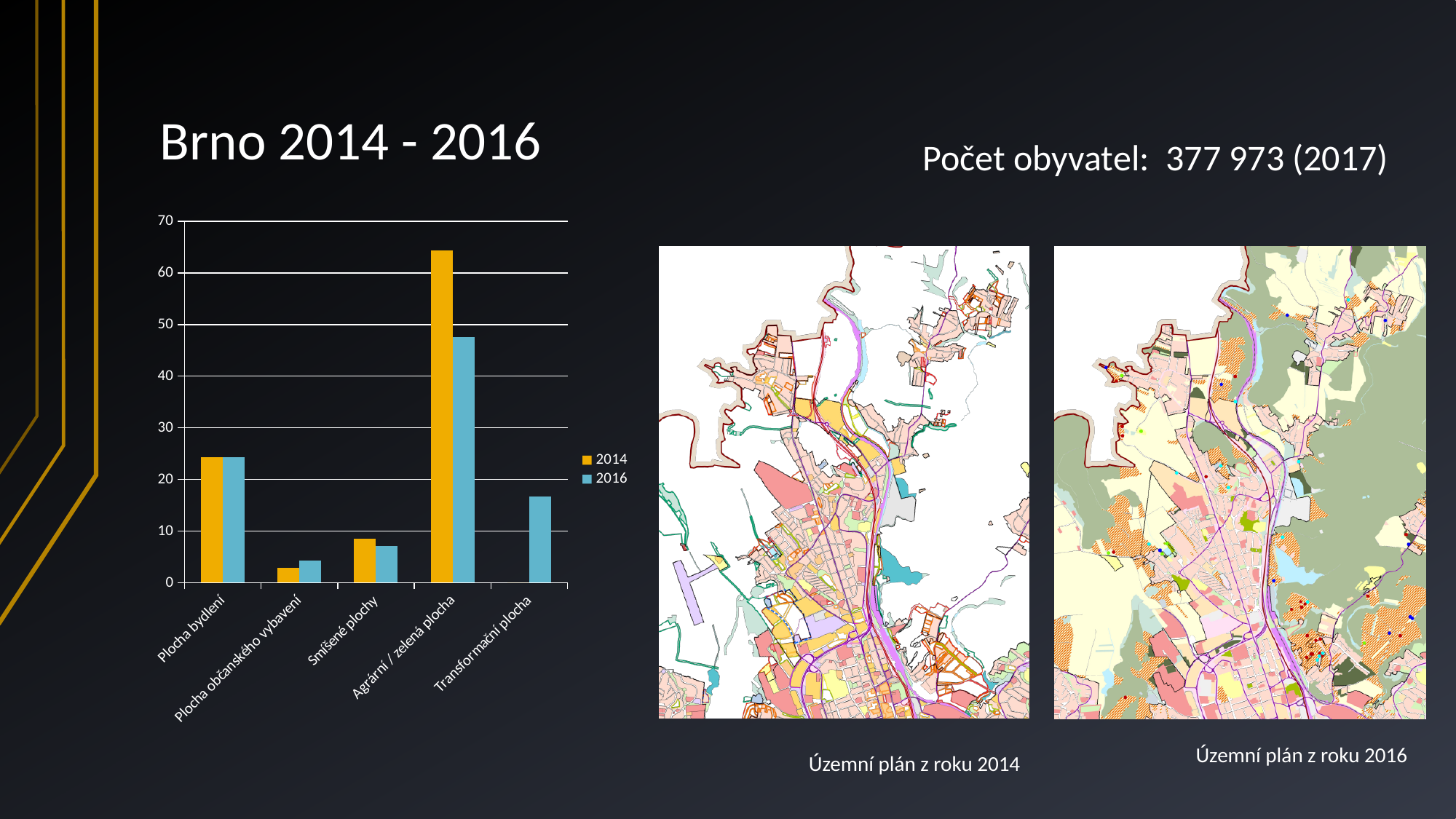
How many categories are shown on the x axis of the chart? 5 Which category has the lowest value for the 2014 series? Transformační plocha Which category has the highest value for the 2014 series? Agrární / zelená plocha Is the 2016 value for Transformační plocha greater or less than 20? less For Plocha občanského vybavení, which series has the larger value, 2014 or 2016? 2016 What are the two entries listed in the chart's legend? 2014 and 2016 What kind of chart is shown on the slide? bar chart Which category has the highest value for the 2016 series? Agrární / zelená plocha For Agrární / zelená plocha, which series has the larger value, 2014 or 2016? 2014 Is the 2014 value for Agrární / zelená plocha greater or less than 60? greater Is the 2016 value for Agrární / zelená plocha greater or less than 50? less How many series does the chart's legend list? 2